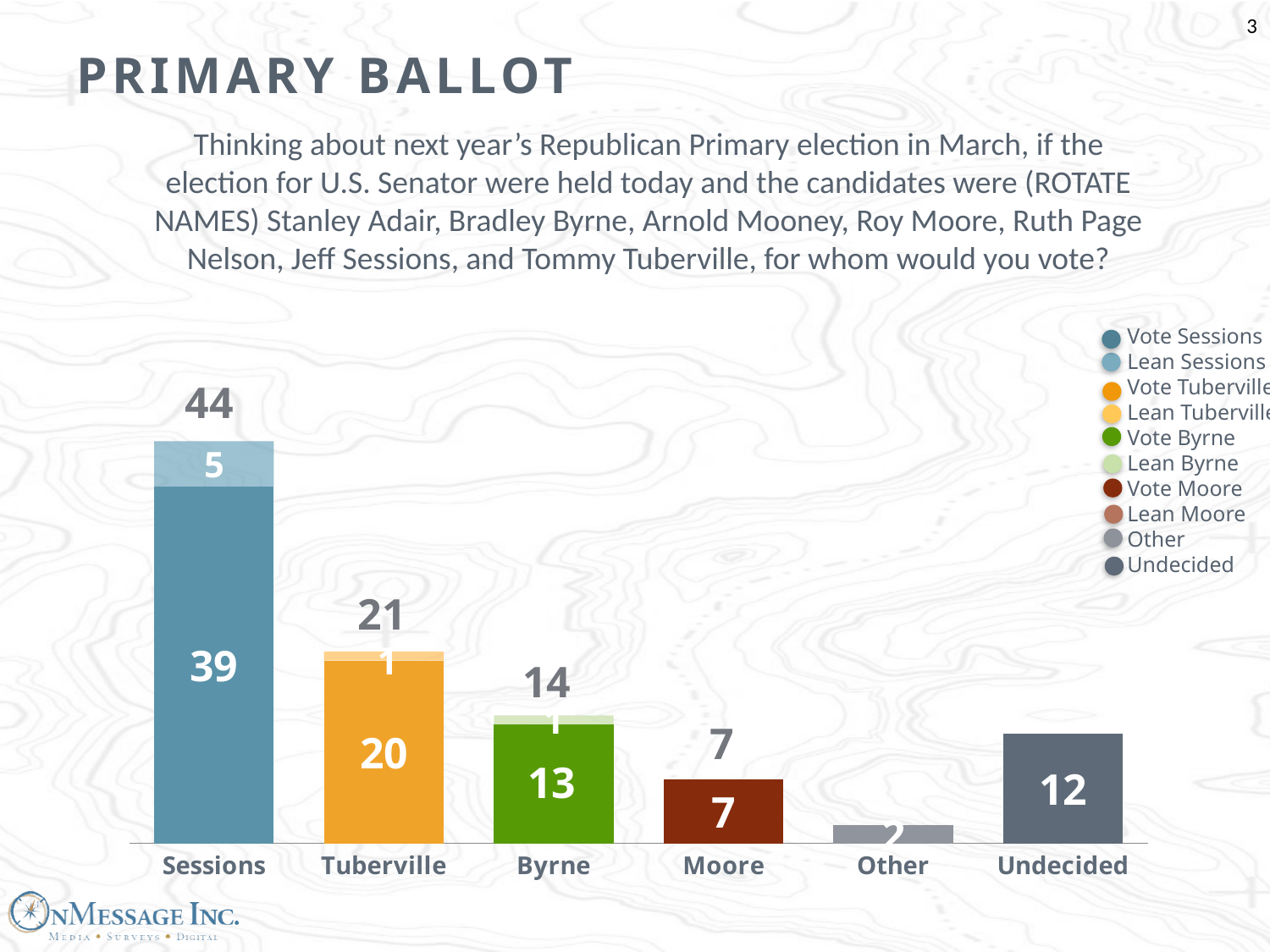
What is the value for Vote Sessions? 39 What is the value for Vote Tuberville? 20 How many categories are shown on the x axis? 6 Which candidate has the highest total? Sessions What is the difference between the Sessions total and the Tuberville total? 23 What is the total value shown above the Sessions bar? 44 What is the total value shown above the Byrne bar? 14 What is the value for Lean Sessions? 5 Which category has the lowest value? Other How many entries does the legend list? 10 Which is larger, the Moore total or the Undecided value? Undecided What is the value for Undecided? 12